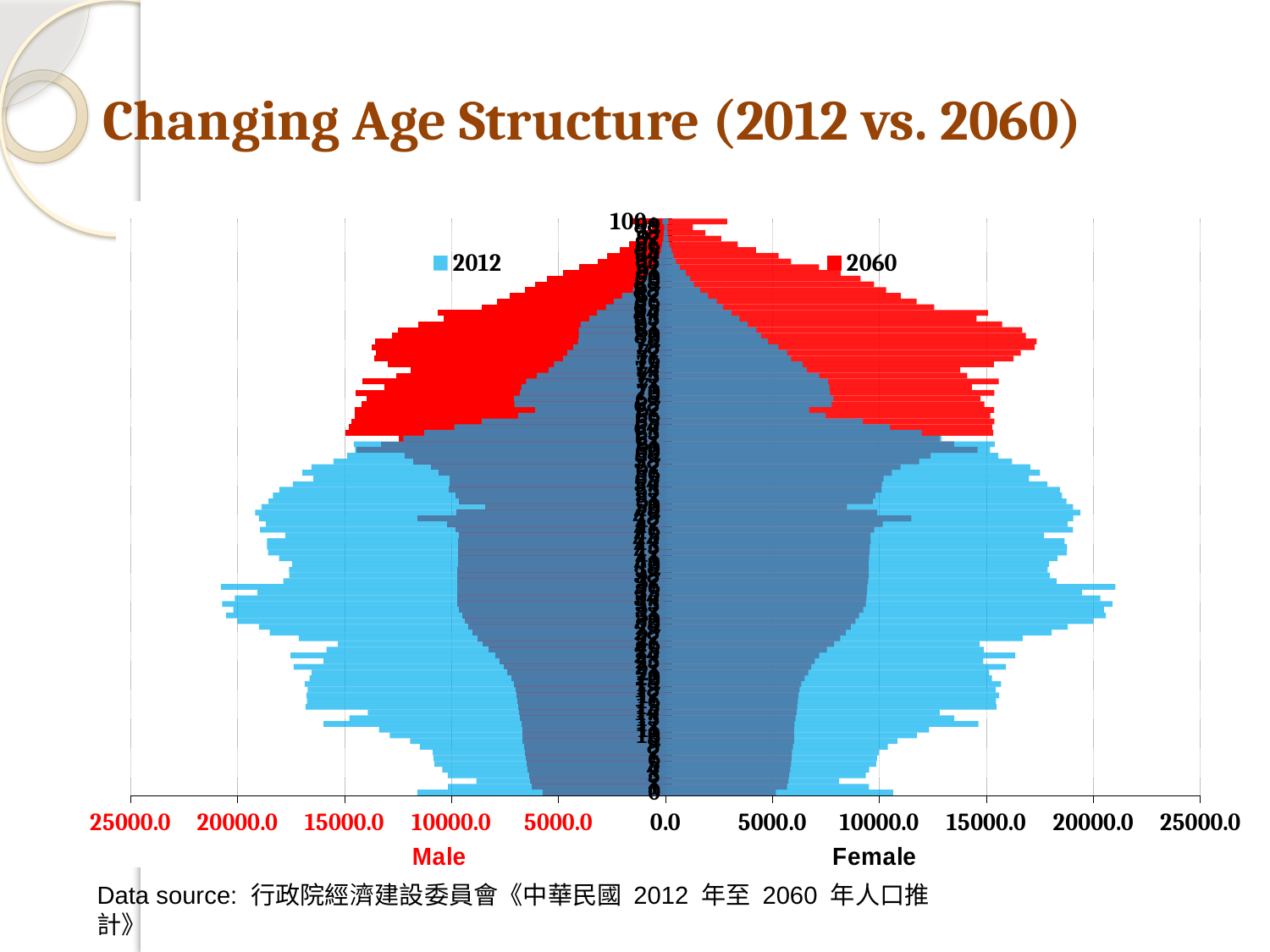
How many series does the legend list? 2 What are the two series named in the legend? 2012 and 2060 Which series has the longer maximum bar, 2012 or 2060? 2012 Is the longest 2012 bar on the Male side greater or less than 20000.0? greater What kind of chart is shown on the slide? bar chart Which series has the longer bars at the oldest ages near the top of the chart, 2012 or 2060? 2060 Is the longest 2012 bar on the Female side greater or less than 20000.0? greater Which colour represents the 2060 series? red Is the longest 2060 bar on the Male side greater or less than 20000.0? less